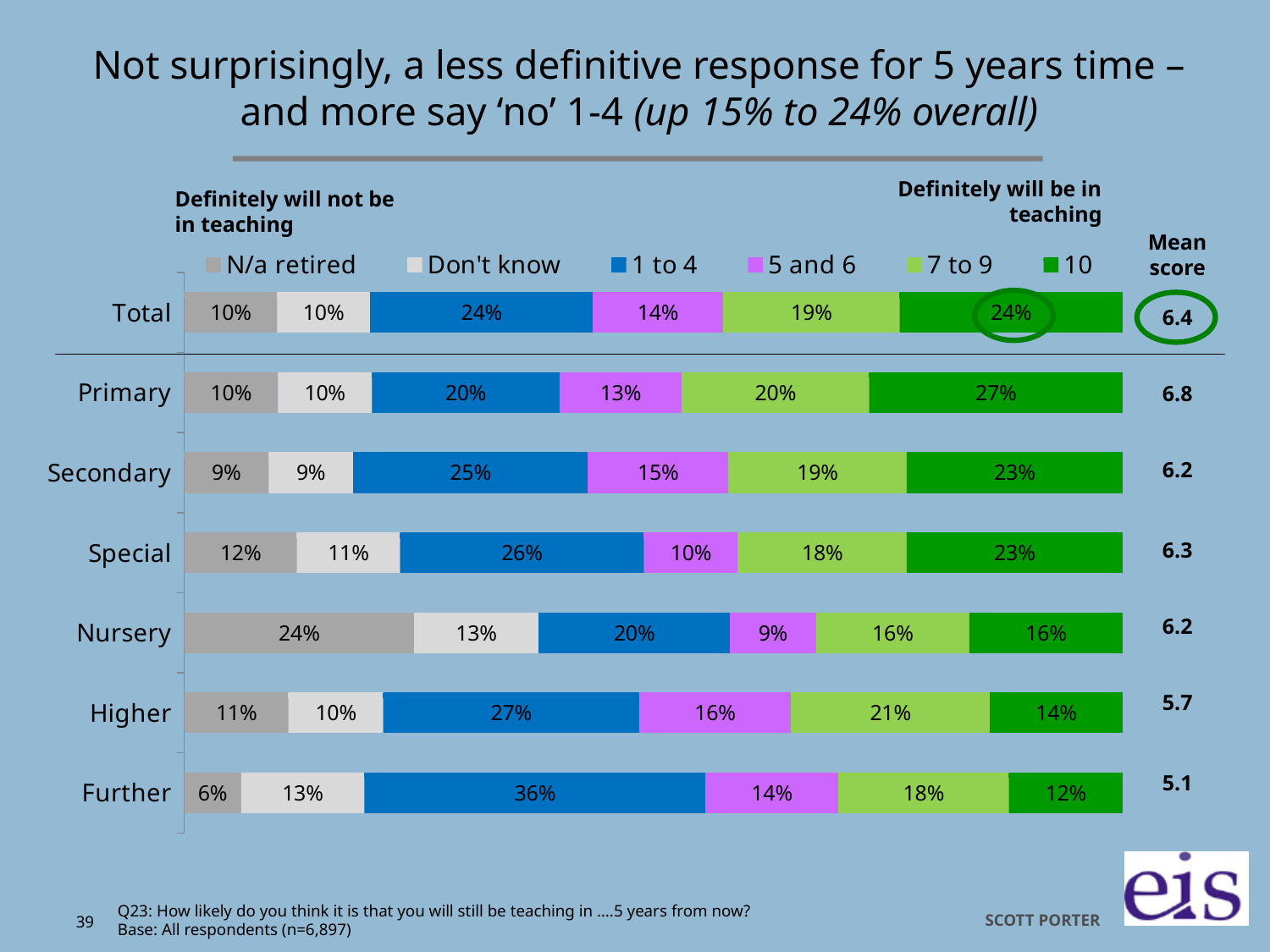
What percentage of Further respondents answered '1 to 4'? 36% Which category has the lowest '10' percentage? Further What percentage of Primary respondents answered '10'? 27% How many series does the legend list? 6 What is the mean score shown for Total? 6.4 What is the difference between the '1 to 4' percentage for Further and for Primary? 16% Is the '7 to 9' percentage larger for Higher or for Nursery? Higher What kind of chart is shown on the slide? Stacked bar chart Which category has the highest 'N/a retired' percentage? Nursery What is the '5 and 6' value for Nursery? 9% Which category has the highest '1 to 4' percentage? Further How many categories (rows) are shown in the chart? 7